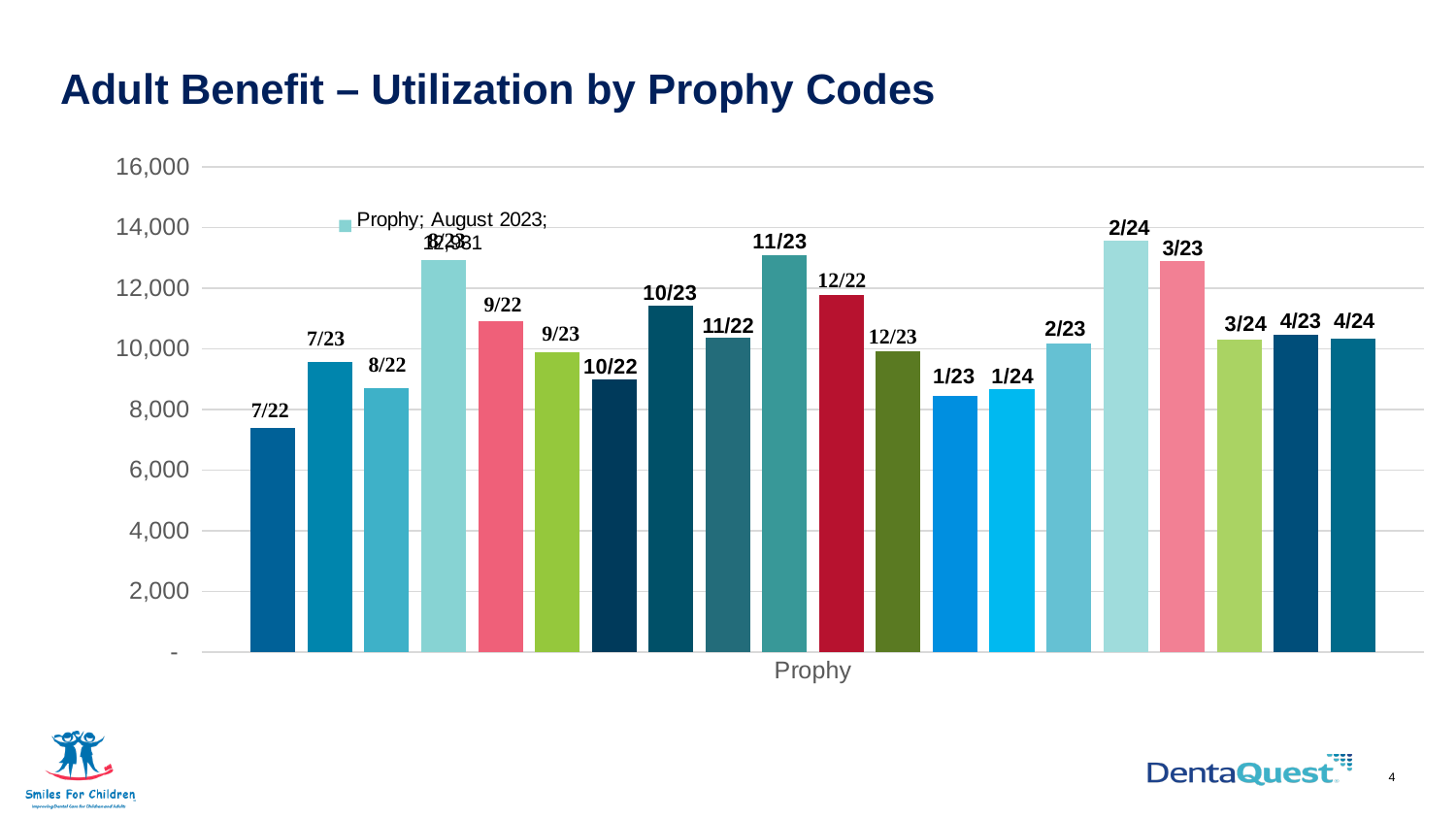
Which month has the highest bar in the chart? 2/24 Which month has the lowest bar in the chart? 7/22 Which is larger, the value for 10/23 or the value for 10/22? 10/23 Is the value for 7/22 greater or less than 8,000? less What value is printed for the 8/23 (August 2023) bar? 12,931 What is the title of the chart on the slide? Adult Benefit – Utilization by Prophy Codes How many bars are plotted in the chart? 20 Is the value for 11/23 greater or less than 12,000? greater Which is larger, the value for 9/22 or the value for 9/23? 9/22 What type of chart is shown on the slide? Bar chart Is the value for 12/22 greater or less than 10,000? greater